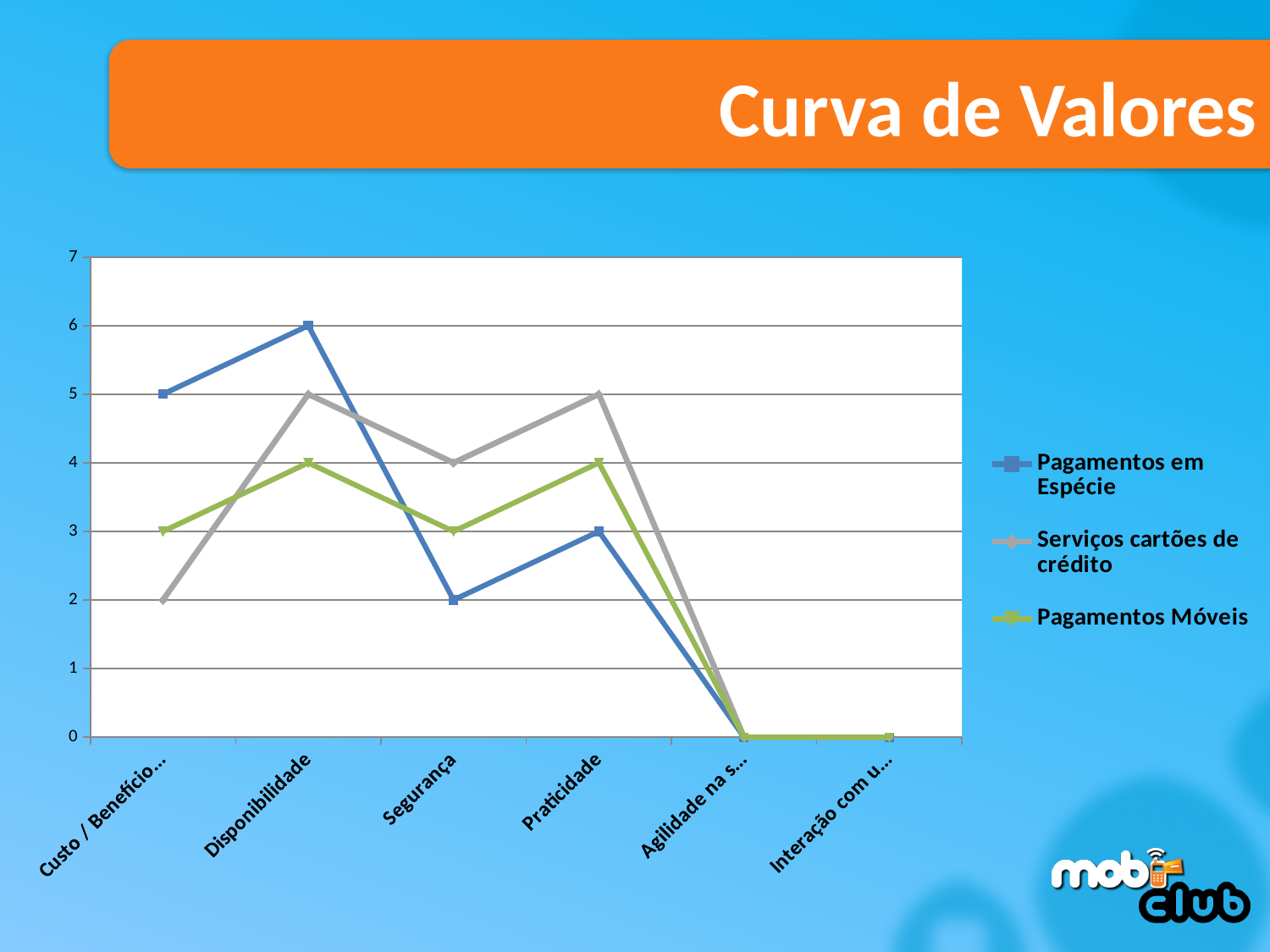
How many series does the legend list? 3 What is the value for Pagamentos Móveis at Praticidade? 4 At which category does Pagamentos em Espécie reach its highest value? Disponibilidade What kind of chart is shown on the slide? Line chart Which series has the lowest value at Custo / Benefício? Serviços cartões de crédito What is the title of the slide containing the chart? Curva de Valores How many categories are shown on the x axis? 6 What is the difference between Pagamentos em Espécie and Pagamentos Móveis at Disponibilidade? 2 What is the value for Serviços cartões de crédito at Segurança? 4 At Segurança, which is larger: Serviços cartões de crédito or Pagamentos em Espécie? Serviços cartões de crédito What is the value for Pagamentos em Espécie at Disponibilidade? 6 Does the Pagamentos em Espécie line rise or fall from Disponibilidade to Segurança? Fall